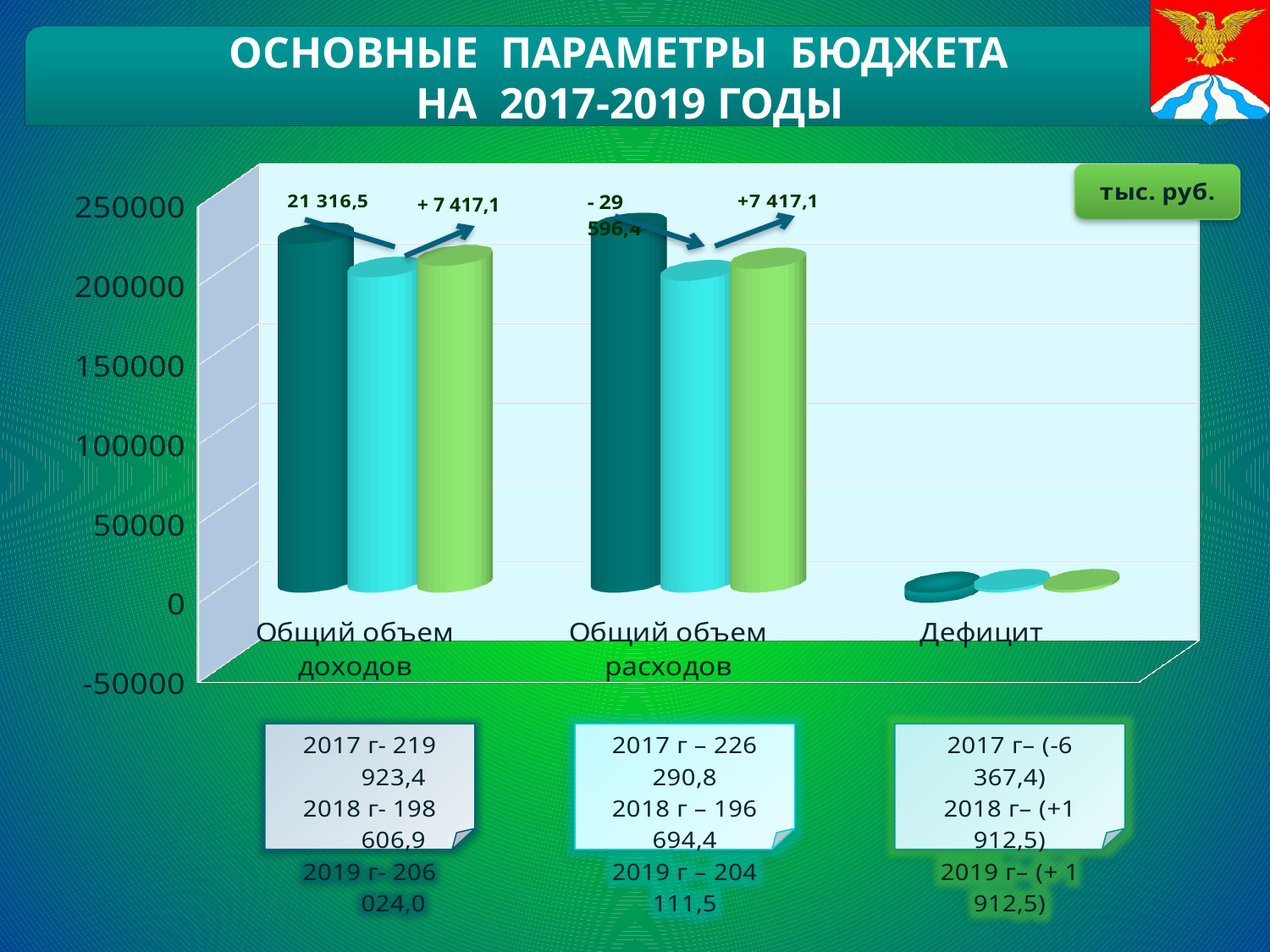
According to the slide, what is the value of "Дефицит" for 2017 г? (-6 367,4) Is the value of the first (2017) bar for "Общий объем доходов" greater or less than 200000? greater What is the difference between "Общий объем доходов" for 2017 г (219 923,4) and 2018 г (198 606,9)? 21 316,5 How many categories are shown on the x axis of the chart? 3 What kind of chart is shown on the slide? bar chart How many bars are plotted for the category "Общий объем доходов"? 3 What is the difference between "Общий объем расходов" for 2017 г (226 290,8) and 2018 г (196 694,4)? 29 596,4 Which category has the lowest bars on the chart? Дефицит Which is larger: "Общий объем расходов" for 2017 г or for 2018 г? 2017 г According to the slide, what is the value of "Общий объем расходов" for 2018 г? 196 694,4 In what units are the chart values given, according to the label on the slide? тыс. руб. According to the slide, what is the value of "Общий объем доходов" for 2017 г? 219 923,4